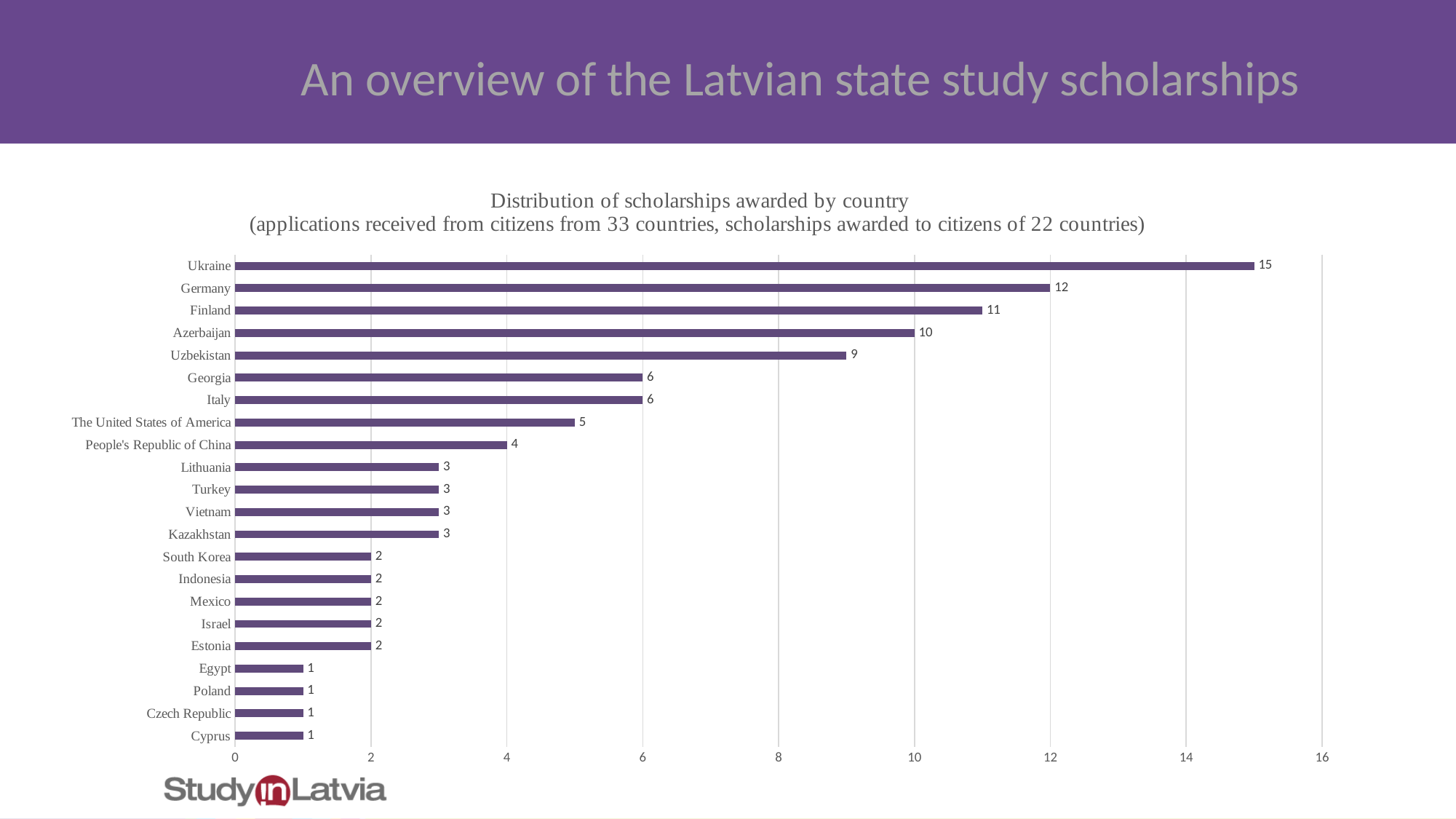
Is the value for Finland greater or less than 10? greater What is the value shown for Azerbaijan? 10 How many countries are listed on the chart? 22 How many scholarships were awarded to citizens of Ukraine? 15 How many countries have a value of 1? 4 Which country received the most scholarships? Ukraine What kind of chart is shown on the slide? Bar chart What is the difference between the values for Germany and Finland? 1 What is the difference between the values for Ukraine and Uzbekistan? 6 What is the title of the chart? Distribution of scholarships awarded by country (applications received from citizens from 33 countries, scholarships awarded to citizens of 22 countries) Which has a higher value, Georgia or People's Republic of China? Georgia How many scholarships were awarded to citizens of The United States of America? 5